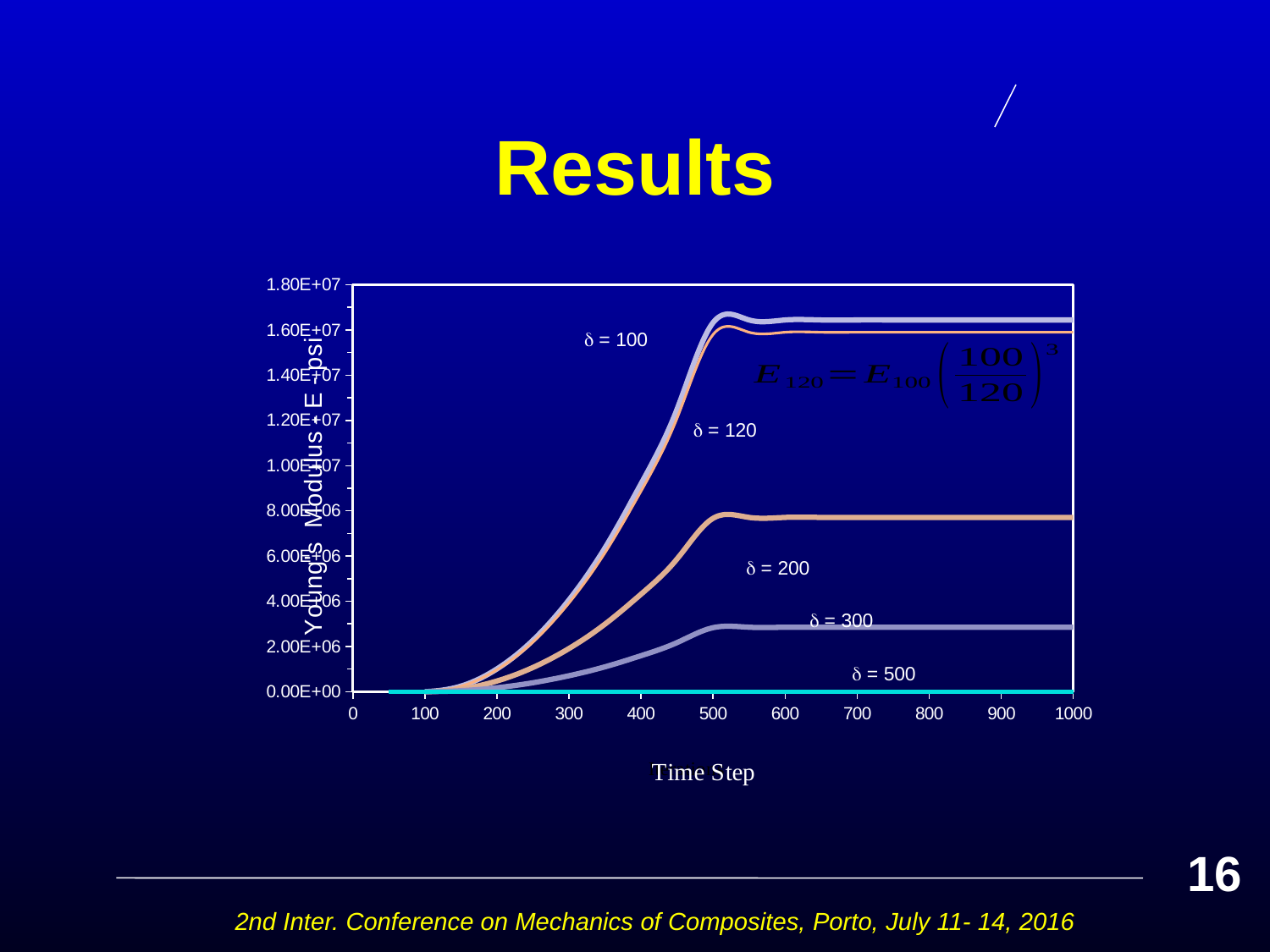
Is the value of the δ = 100 curve at time step 1000 greater or less than 1.40E+07? greater Is the value of the δ = 200 curve at time step 1000 greater or less than 6.00E+06? greater What kind of chart is shown on the slide? line chart How many curves (δ values) are plotted on the chart? 5 Is the value of the δ = 300 curve at time step 1000 greater or less than 4.00E+06? less At time step 1000, which curve has the larger Young's modulus, δ = 120 or δ = 200? δ = 120 Which curve has the lowest Young's modulus at time step 1000? δ = 500 What is the label of the x axis of the chart? Time Step Which curve has the highest Young's modulus at time step 1000? δ = 100 Between time step 200 and time step 500, does the δ = 120 curve rise or fall? rise At time step 1000, which curve has the larger Young's modulus, δ = 200 or δ = 300? δ = 200